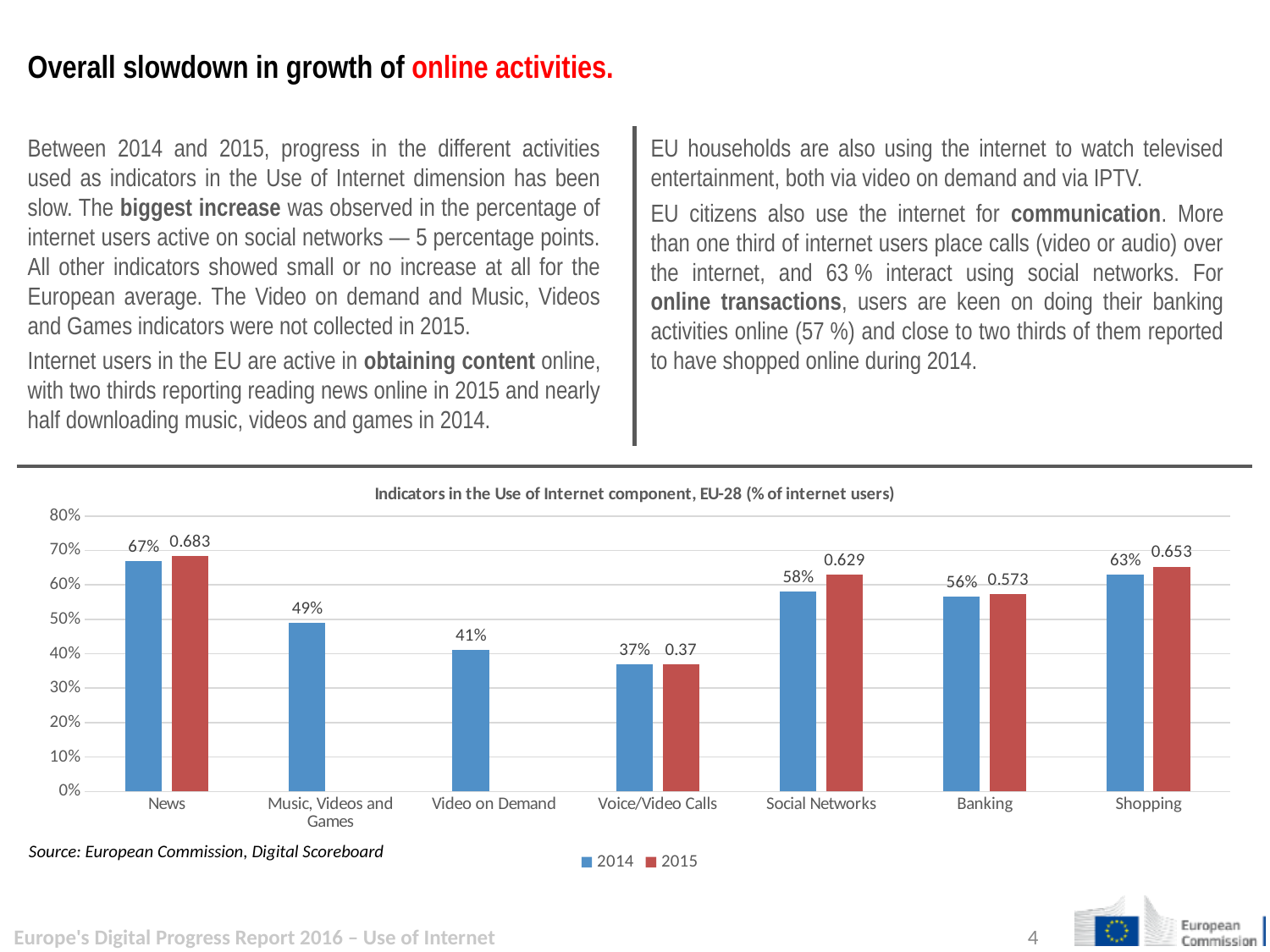
Which category has the lowest 2014 value? Voice/Video Calls What is the difference in percentage points between the 2014 values for News and Shopping? 4 percentage points What is the 2014 value for News? 67% Which two categories have no 2015 bar? Music, Videos and Games; Video on Demand What is the 2015 value for Banking, as labelled on the chart? 0.573 What is the 2014 value for Music, Videos and Games? 49% What kind of chart is shown on the slide? Bar chart Which has the larger 2014 value, Social Networks or Banking? Social Networks How many categories are shown on the x axis? 7 How many series does the legend list? 2 What is the 2015 value for Social Networks, as labelled on the chart? 0.629 Which category has the highest 2014 value? News